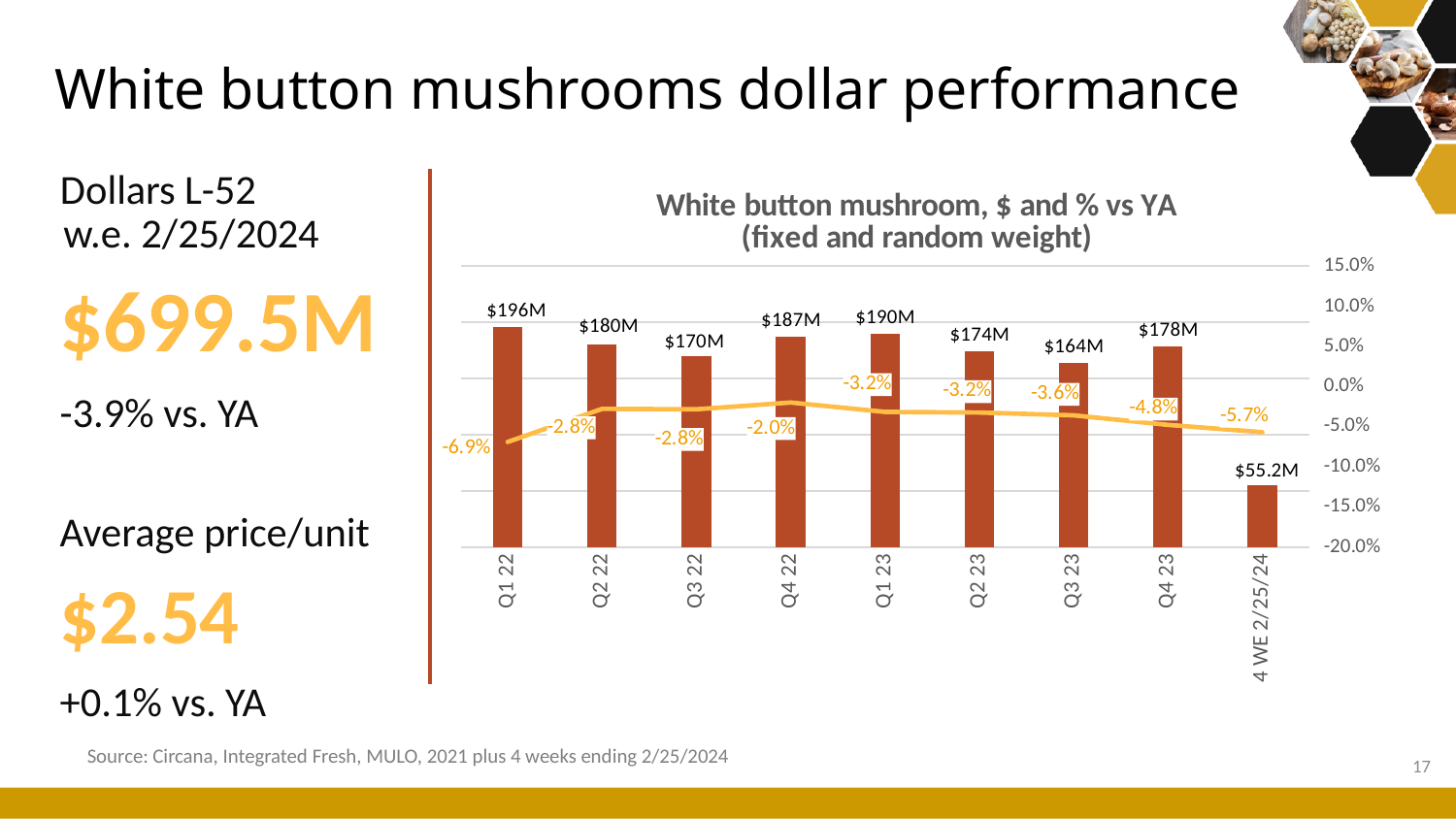
What is the dollar value shown for the 4 WE 2/25/24 period? $55.2M Which quarter has the lowest dollar value among the quarterly bars (excluding the 4 WE 2/25/24 period)? Q3 23 What is the title of the chart? White button mushroom, $ and % vs YA (fixed and random weight) What is the % vs YA value shown for Q4 23? -4.8% What is the dollar value shown for Q1 22? $196M What is the difference in dollars between Q1 23 and Q2 23? $16M Which quarter has the highest dollar value among the quarterly bars? Q1 22 Which is larger, the dollar value for Q4 22 or Q4 23? Q4 22 Which period has the lowest % vs YA value on the line? Q1 22 What is the % vs YA value shown for Q4 22? -2.0% What kind of chart is shown on the slide? Combination bar and line chart How many periods are shown on the x axis of the chart? 9